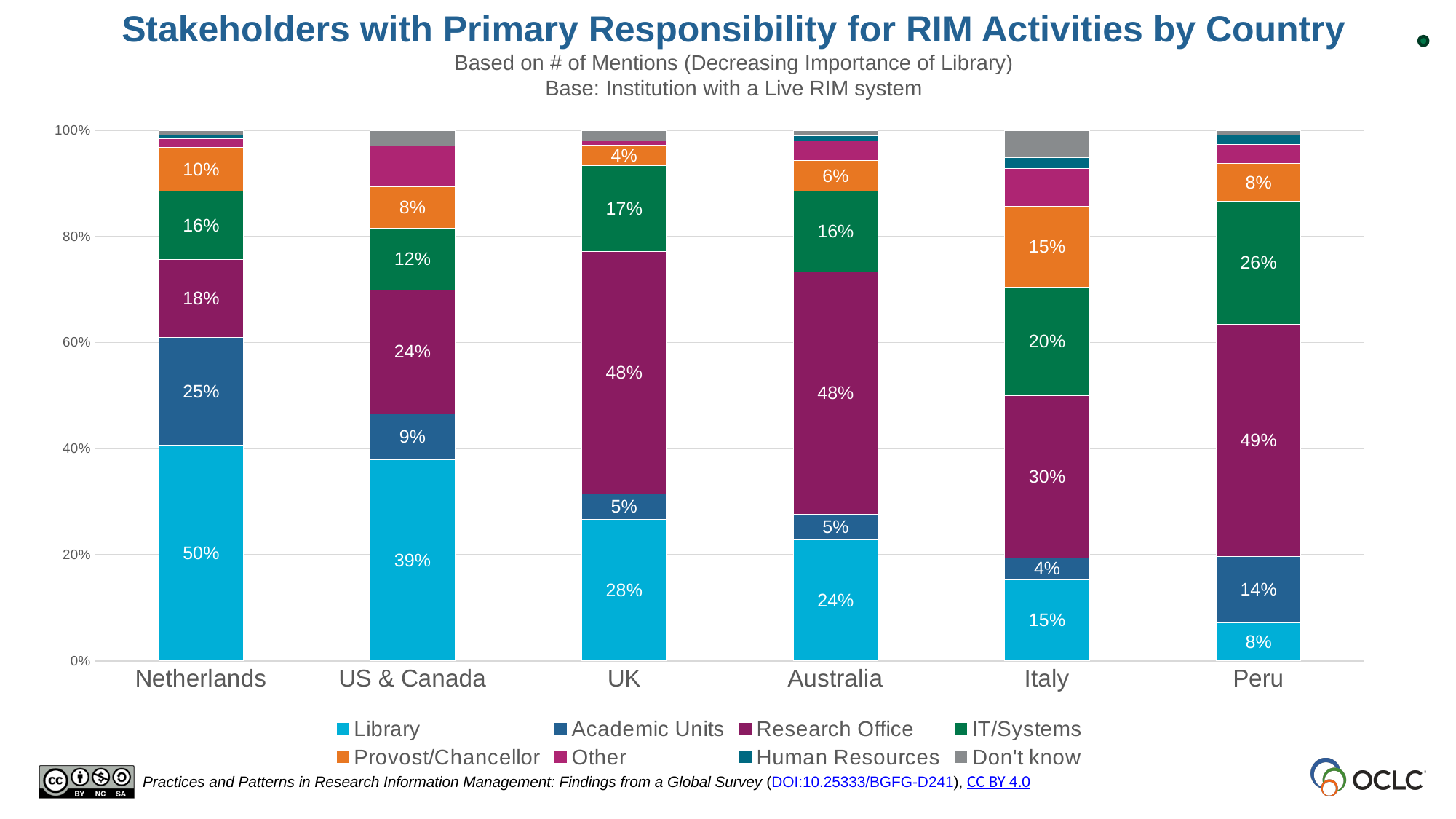
What kind of chart is shown on the slide? Stacked bar chart What is the Research Office share for Peru? 49% Which series is shown in orange in the legend? Provost/Chancellor How many series does the legend list? 8 What is the Library share for the Netherlands? 50% Which country has the lowest Library share? Peru Which is larger, the Academic Units share for the Netherlands or for Peru? Netherlands What is the difference between the IT/Systems share for Peru and for US & Canada? 14% What is the Provost/Chancellor share for Italy? 15% How many countries or regions are shown on the x axis? 6 What is the Academic Units share for US & Canada? 9% Which country has the highest Library share? Netherlands